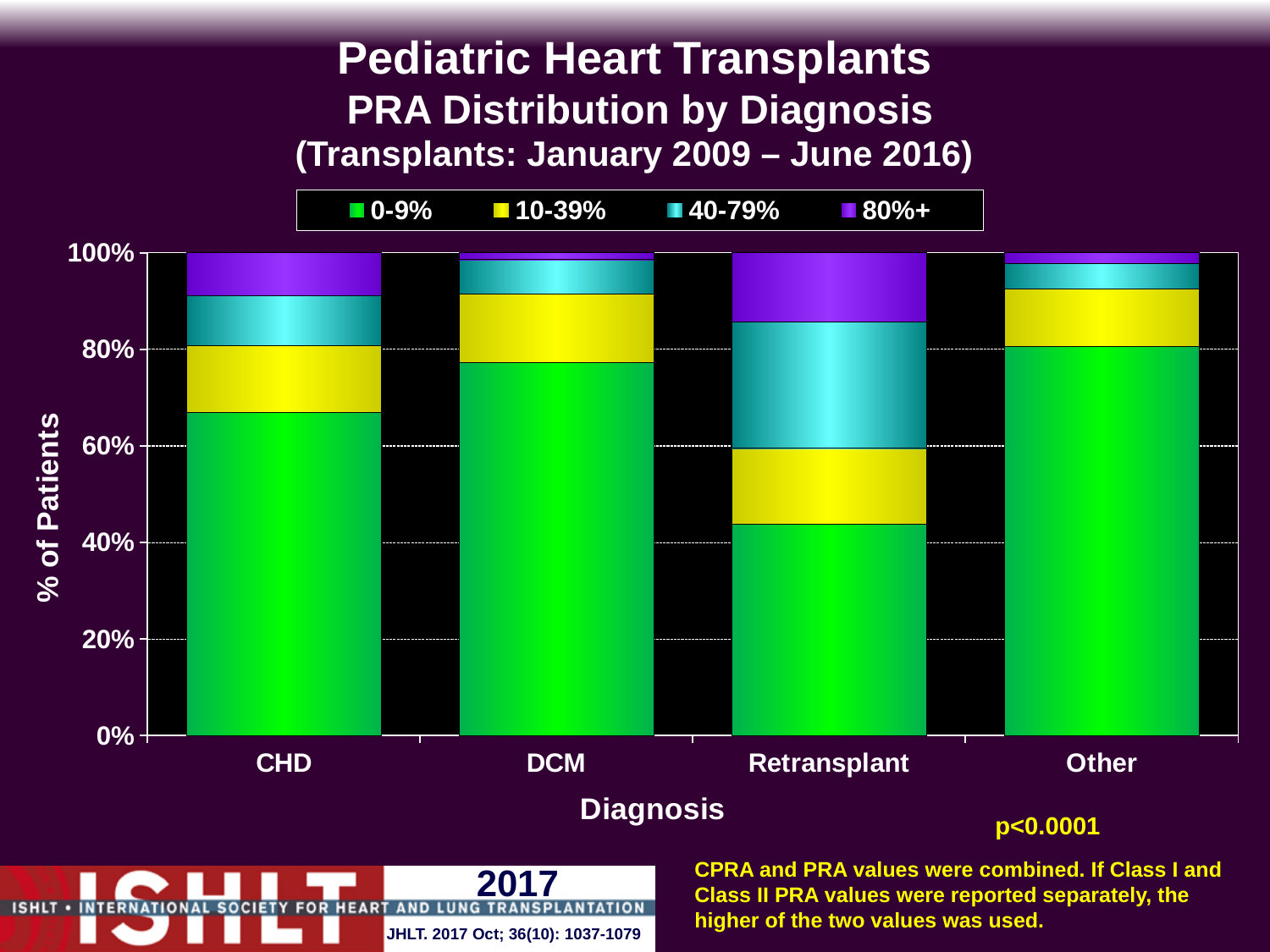
What kind of chart is shown on the slide? Stacked bar chart What is the label of the y axis? % of Patients Which diagnosis has the largest 80%+ PRA segment? Retransplant Is the 0-9% PRA share for CHD greater or less than 60%? greater Which diagnosis has the largest 40-79% PRA segment? Retransplant Which diagnosis has the smallest 0-9% PRA segment? Retransplant How many PRA groups does the legend list? 4 Is the 0-9% PRA share for DCM greater or less than 60%? greater How many diagnosis categories are shown on the x axis? 4 What do the segments of each stacked bar add up to? 100% Which has a larger 0-9% PRA share, CHD or Retransplant? CHD Is the 0-9% PRA share for Retransplant greater or less than 60%? less